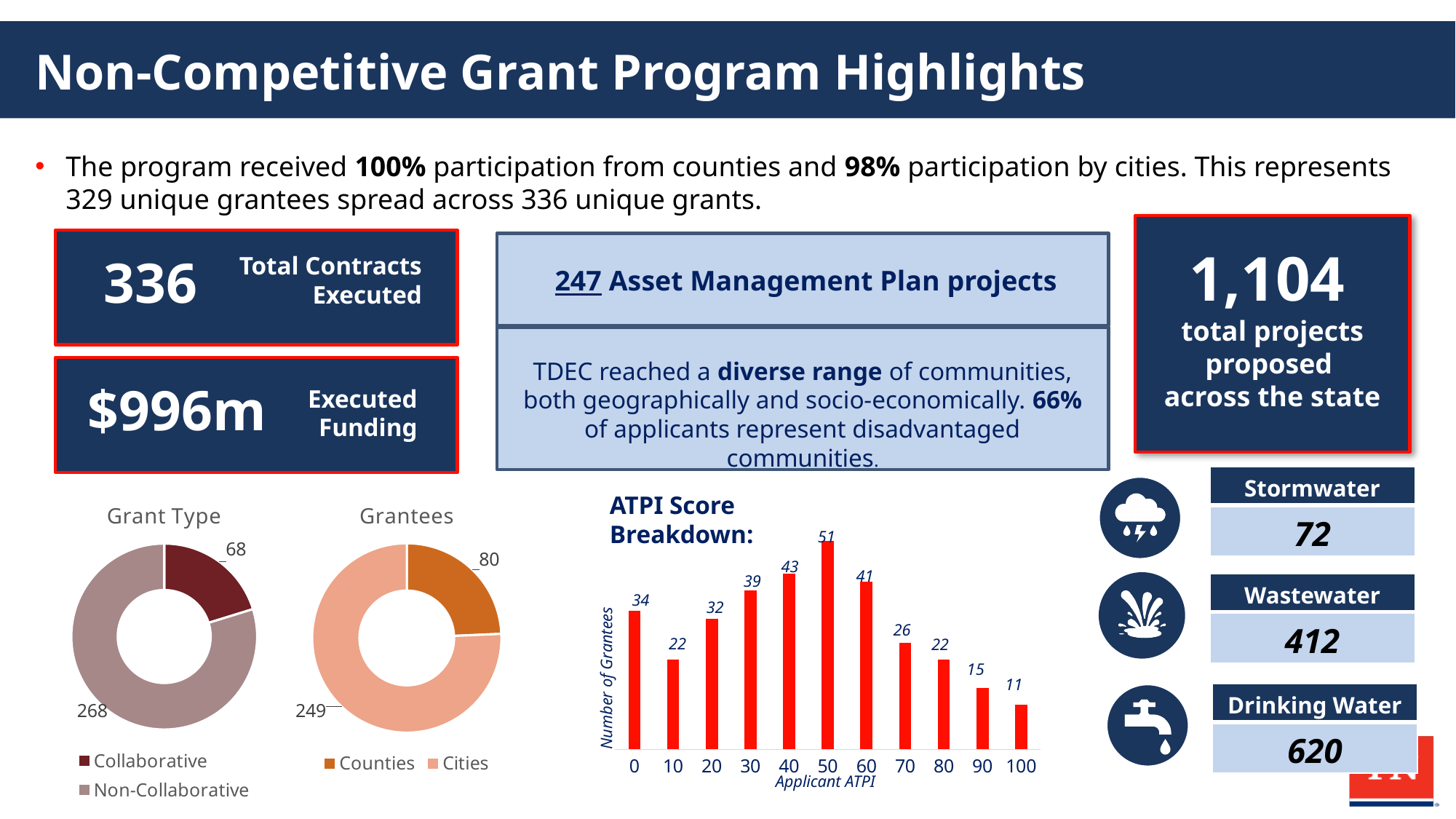
In the ATPI Score Breakdown chart, how many grantees have an Applicant ATPI of 50? 51 In the ATPI Score Breakdown chart, how many bars are plotted? 11 In the Grantees chart, which category is larger, Counties or Cities? Cities In the Grant Type chart, what is the value for Non-Collaborative? 268 In the ATPI Score Breakdown chart, which Applicant ATPI value has the lowest number of grantees? 100 In the Grantees chart, what is the value for Counties? 80 In the ATPI Score Breakdown chart, what is the difference in number of grantees between ATPI 40 and ATPI 70? 17 What kind of chart is the Grant Type chart? Donut (pie) chart In the ATPI Score Breakdown chart, what is the label of the y axis? Number of Grantees In the Grant Type chart, what is the value for Collaborative? 68 In the Grantees chart, what is the difference between Cities and Counties? 169 In the ATPI Score Breakdown chart, which Applicant ATPI value has the highest number of grantees? 50